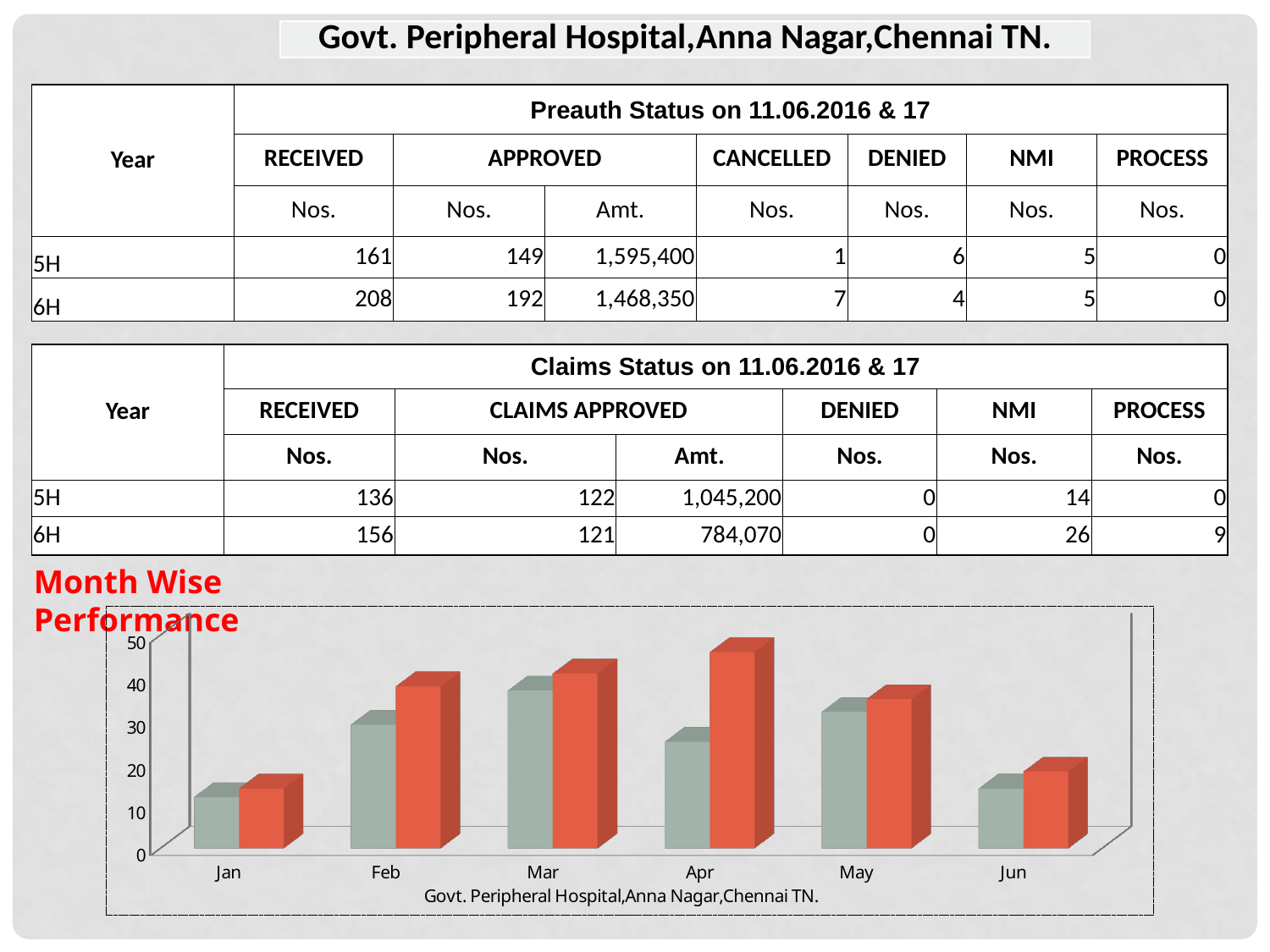
In the bar chart, which month has the tallest red bar? Apr In the bar chart, is the red bar for Feb greater or less than 30? greater In the bar chart, is the grey bar for Jan greater or less than 20? less What kind of chart is shown under the heading 'Month Wise Performance'? bar chart In the bar chart, is the red bar for Apr greater or less than 40? greater In the bar chart, which month has the tallest grey bar? Mar What text appears below the x axis of the bar chart? Govt. Peripheral Hospital,Anna Nagar,Chennai TN. How many months are shown on the x axis of the bar chart? 6 In the bar chart, which is larger for Apr: the red bar or the grey bar? the red bar In the bar chart, which month has the shortest red bar? Jan